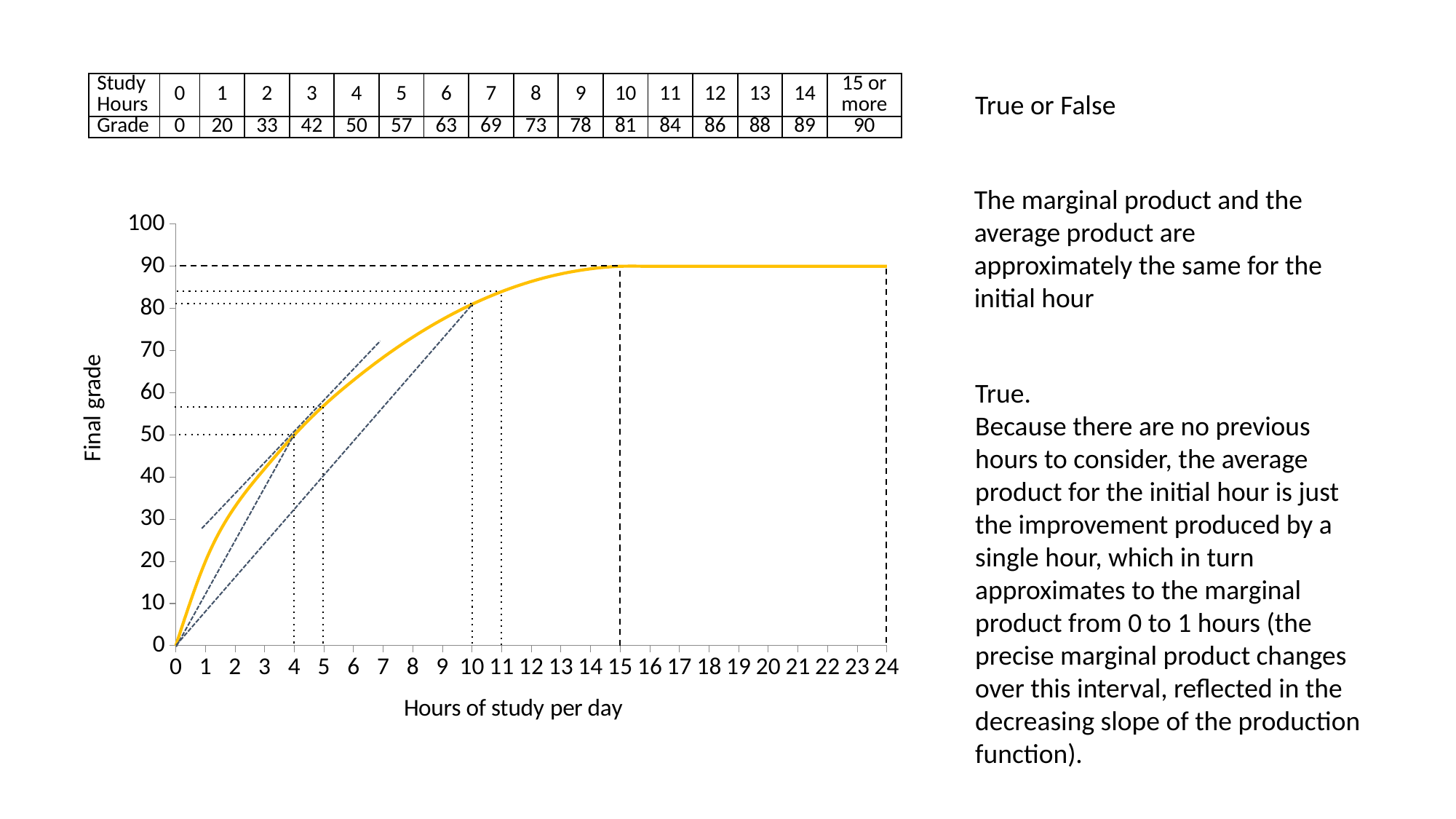
What is the highest final grade reached on the chart? 90 What is the difference in final grade between 1 study hour and 0 study hours? 20 Is the final grade at 24 hours of study per day greater or less than 80? greater What kind of chart is shown on the slide? line chart What is the label of the y axis of the chart? Final grade According to the table, what is the final grade for 15 or more study hours? 90 According to the table, what is the final grade for 10 study hours? 81 What is the label of the x axis of the chart? Hours of study per day According to the table, what is the final grade for 4 study hours? 50 What is the difference in final grade between 10 study hours and 4 study hours? 31 Which is larger, the final grade at 7 study hours or at 5 study hours? 7 study hours Does the final grade rise or fall as hours of study increase from 0 to 15? rise